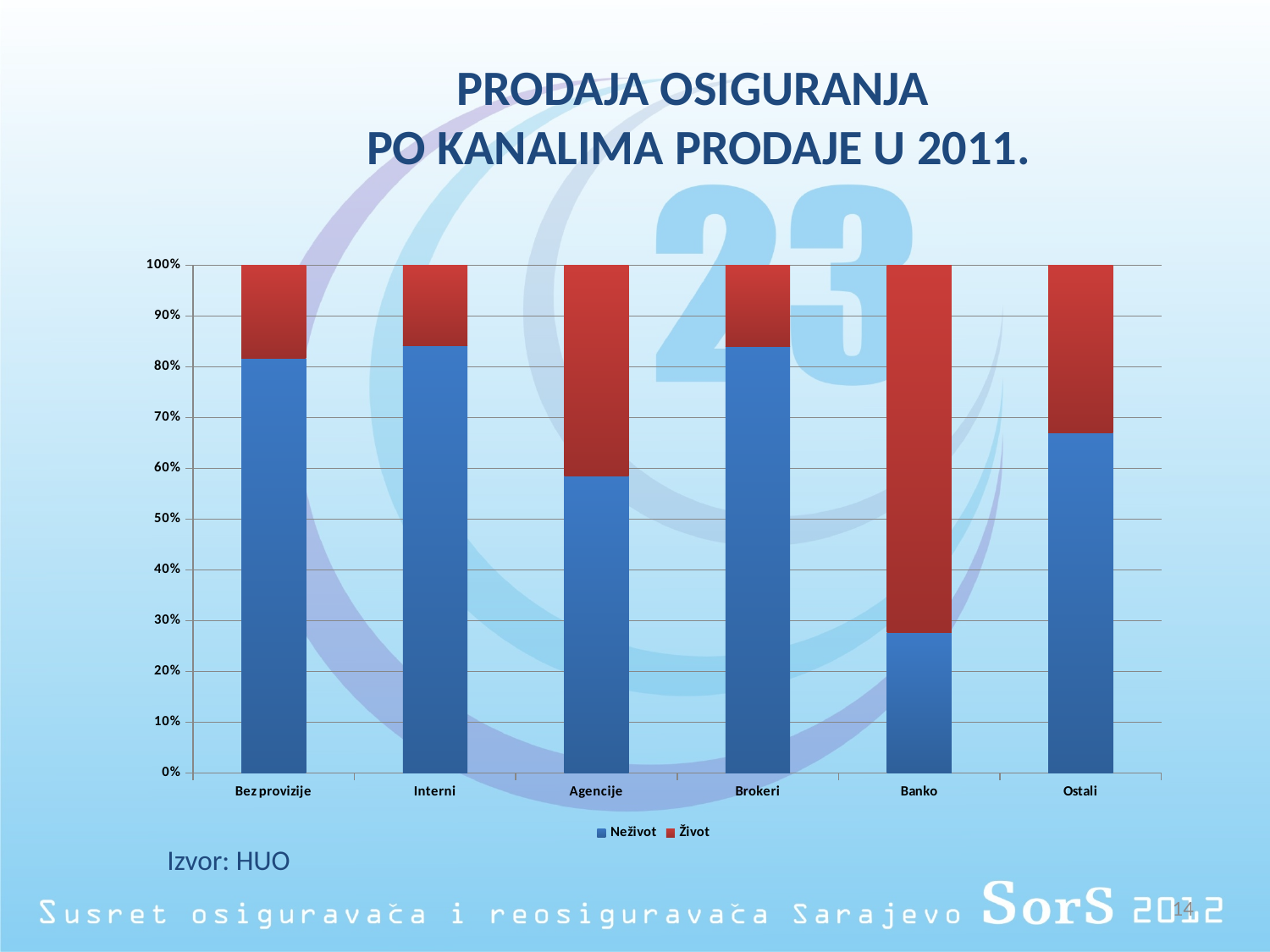
Is the Neživot share for Ostali greater or less than 70%? less What kind of chart is shown on the slide? Stacked bar chart How many sales channels (categories) are shown on the x axis? 6 What is the total of the stacked bar for Brokeri? 100% Is the Neživot share for Interni greater or less than 80%? greater Which has a larger Neživot share, Agencije or Ostali? Ostali Which sales channel has the lowest Neživot share? Banko Is the Neživot share for Agencije greater or less than 50%? greater Which colour represents the Život series in the legend? Red How many series does the legend list? 2 Which sales channel has the highest Život share? Banko